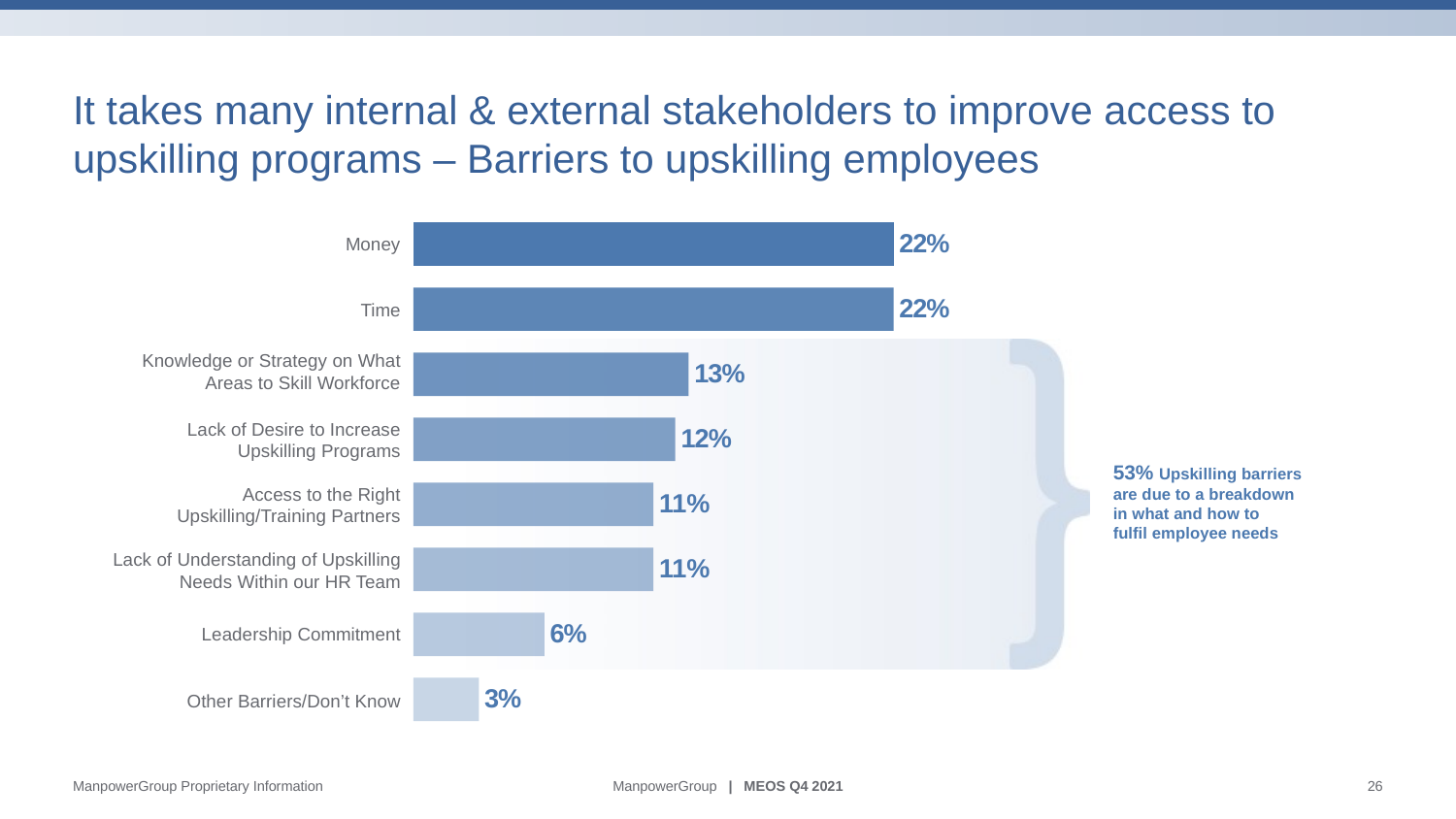
What is the difference between the values for Knowledge or Strategy on What Areas to Skill Workforce and Access to the Right Upskilling/Training Partners? 2% What is the value for Lack of Desire to Increase Upskilling Programs? 12% How many categories are shown in the chart? 8 What is the value for Other Barriers/Don't Know? 3% What is the value for Money? 22% Which two categories share the highest value of 22%? Money and Time What is the value for Leadership Commitment? 6% What is the difference between the values for Time and Leadership Commitment? 16% Which category has the lowest value? Other Barriers/Don't Know What kind of chart is shown on the slide? Bar chart Which is larger, the value for Lack of Desire to Increase Upskilling Programs or the value for Leadership Commitment? Lack of Desire to Increase Upskilling Programs According to the callout next to the chart, what percentage of upskilling barriers are due to a breakdown in what and how to fulfil employee needs? 53%